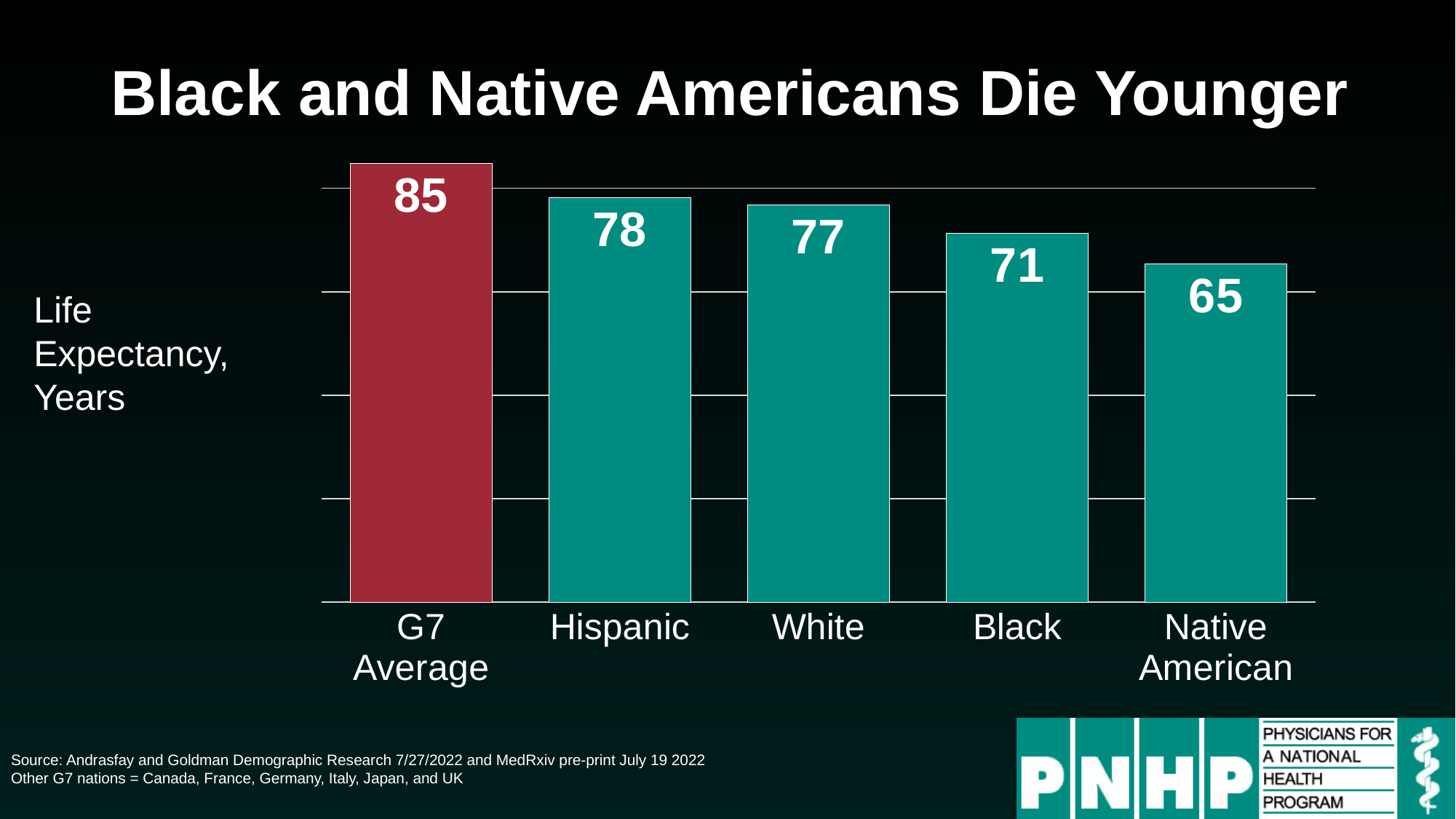
Which category has the highest life expectancy? G7 Average What is the life expectancy value shown for Hispanic? 78 How many categories are shown in the chart? 5 What is the life expectancy value shown for the G7 Average? 85 What is the life expectancy value shown for Native American? 65 Which has a higher life expectancy, Hispanic or Black? Hispanic What is the difference in life expectancy between the G7 Average and Native American? 20 What kind of chart is shown on the slide? Bar chart Which category has the lowest life expectancy? Native American What is the life expectancy value shown for Black? 71 Which bar is shown in a different colour (red) from the others? G7 Average What is the difference in life expectancy between White and Black? 6